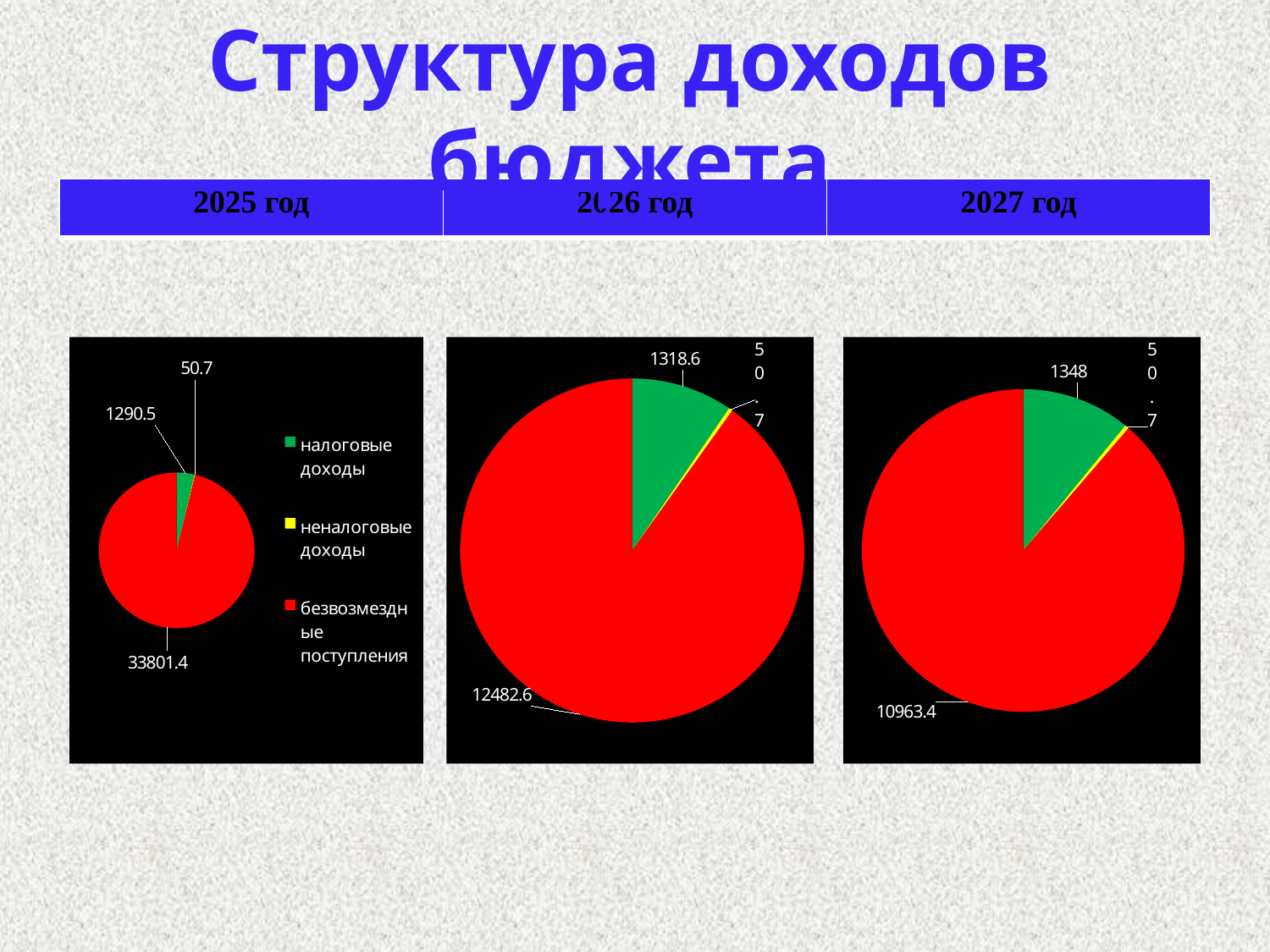
What is the difference between налоговые доходы in the 2026 год chart and in the 2025 год chart? 28.1 What type of chart is used for the 2026 год data? pie chart In the 2025 год pie chart, which category has the smallest slice? неналоговые доходы What is the total of all slices in the 2027 год pie chart? 12362.1 Which is larger: налоговые доходы in the 2026 год chart or налоговые доходы in the 2027 год chart? 2027 год How many slices does the 2025 год pie chart have? 3 In the 2026 год pie chart, which category has the largest slice? безвозмездные поступления In the 2027 год pie chart, what is the value for безвозмездные поступления? 10963.4 In the 2026 год pie chart, what is the value for налоговые доходы? 1318.6 In the 2025 год pie chart, what is the value for безвозмездные поступления? 33801.4 How many entries does the legend list? 3 In the 2027 год pie chart, what is the value for неналоговые доходы? 50.7